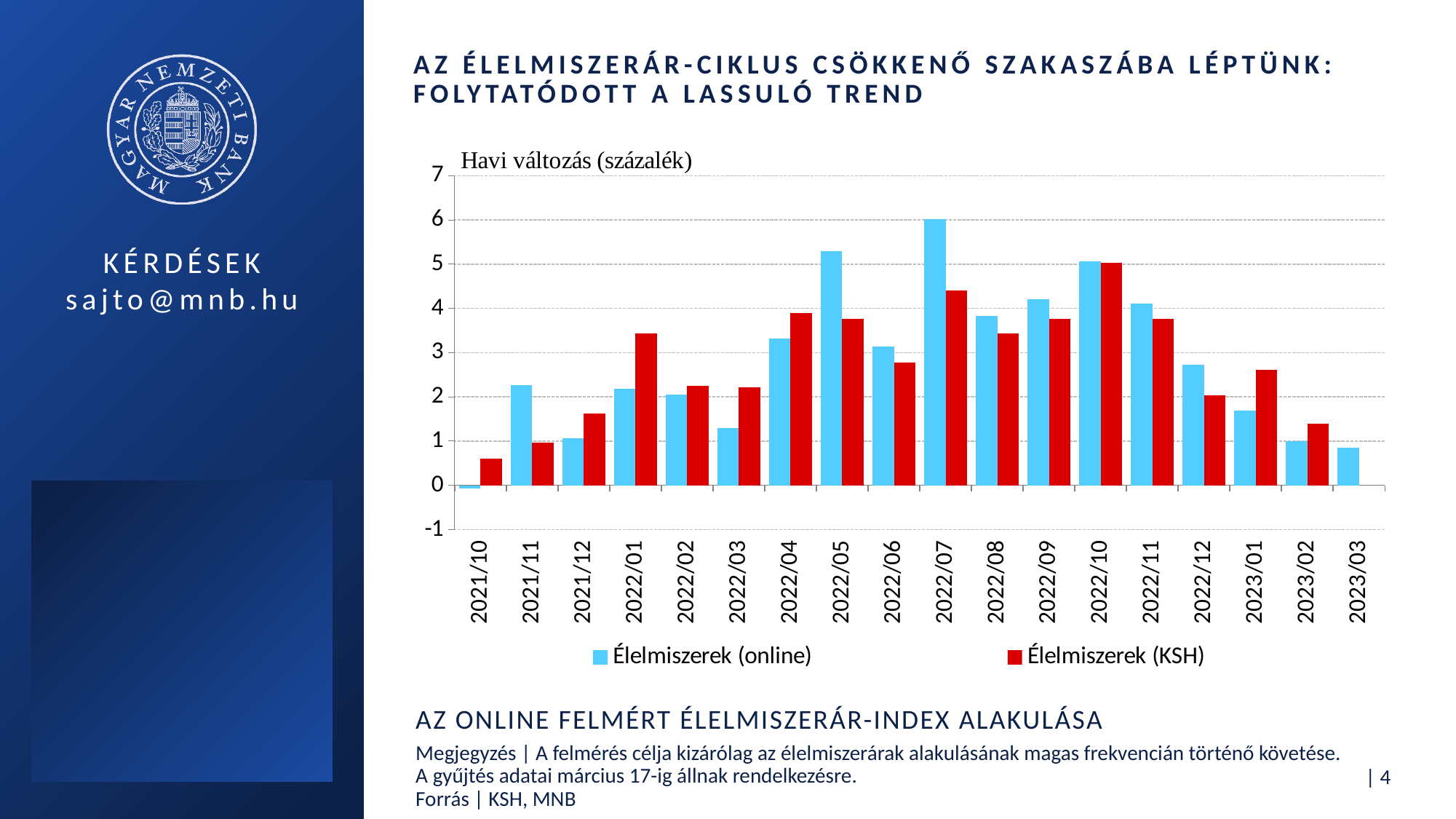
Which is larger in 2022/01, the Élelmiszerek (online) value or the Élelmiszerek (KSH) value? Élelmiszerek (KSH) Do the Élelmiszerek (online) values rise or fall from 2022/10 to 2023/03? fall How many months are shown on the x axis? 18 In which month is the Élelmiszerek (online) value highest? 2022/07 What is the label shown above the vertical axis of the chart? Havi változás (százalék) Is the Élelmiszerek (online) value for 2022/07 greater or less than 5? greater Is the Élelmiszerek (online) value for 2022/05 greater or less than 5? greater Is the Élelmiszerek (KSH) value for 2023/02 greater or less than 2? less Which is larger in 2022/05, the Élelmiszerek (online) value or the Élelmiszerek (KSH) value? Élelmiszerek (online) How many series does the legend list? 2 In which month is the Élelmiszerek (KSH) value highest? 2022/10 What kind of chart is shown on the slide? bar chart